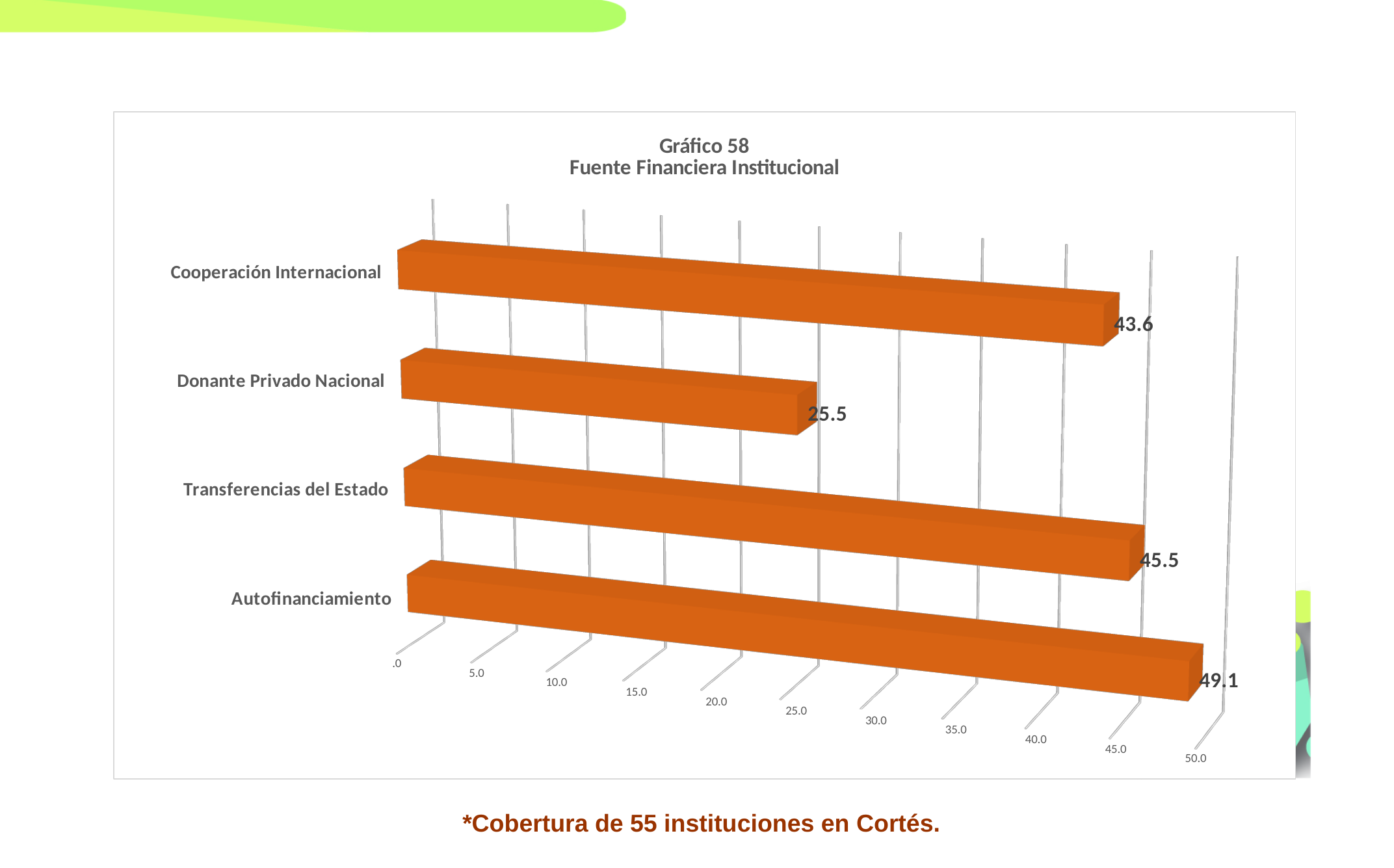
Which category has the highest value? Autofinanciamiento What is the title of the chart? Gráfico 58 Fuente Financiera Institucional What kind of chart is shown on the slide? Bar chart Which category has the lowest value? Donante Privado Nacional What is the difference between the values for Transferencias del Estado and Cooperación Internacional? 1.9 What is the value for Transferencias del Estado? 45.5 What is the value for Donante Privado Nacional? 25.5 How many categories are shown in the chart? 4 What is the value for Autofinanciamiento? 49.1 Which is larger, the value for Transferencias del Estado or the value for Cooperación Internacional? Transferencias del Estado What is the value for Cooperación Internacional? 43.6 What is the difference between the values for Autofinanciamiento and Donante Privado Nacional? 23.6